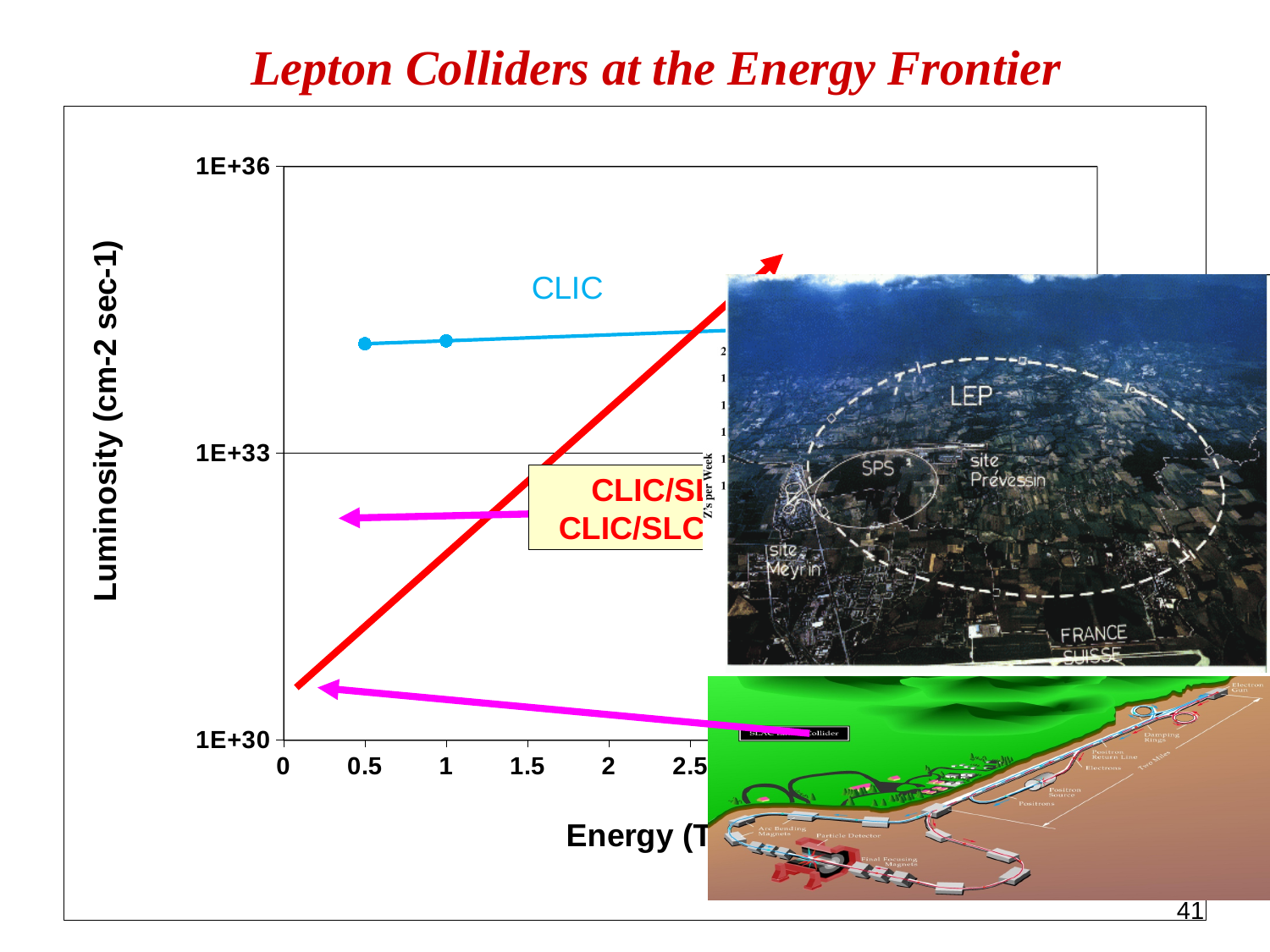
Which series on the chart is labelled in blue text near its line? CLIC What is the label of the vertical axis of the chart? Luminosity (cm-2 sec-1) What kind of chart is shown on the slide? line chart Does the red line on the chart rise or fall as energy increases along the x axis? rise Is the CLIC luminosity value at 1 TeV greater or less than 1E+36? less Is the CLIC luminosity value at 0.5 TeV greater or less than 1E+30? greater Is the CLIC luminosity value at 0.5 TeV greater or less than 1E+33? greater What is the highest tick value shown on the vertical axis of the chart? 1E+36